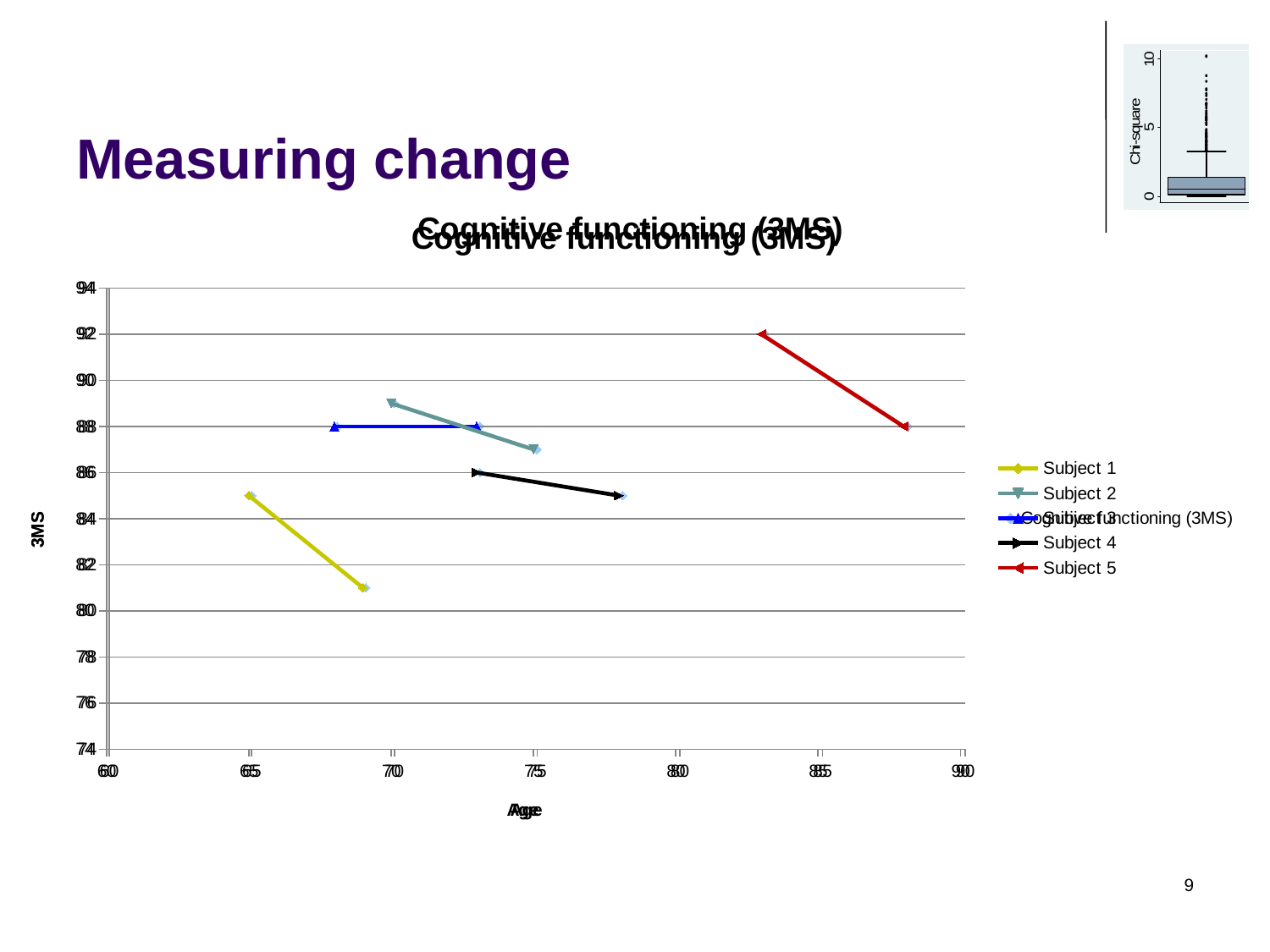
Does Subject 5's 3MS score rise or fall as age increases? fall Which subject reaches the highest 3MS value in the main chart? Subject 5 What is the highest 3MS value reached by Subject 5? 92 Does Subject 1's 3MS score rise or fall as age increases? fall What is the label of the x axis of the main chart? Age At what 3MS value does Subject 3's line stay flat? 88 Which subject has the lowest 3MS value in the main chart? Subject 1 Is the starting 3MS value for Subject 5 greater or less than 90? greater Is the final 3MS value for Subject 1 greater or less than 84? less What kind of chart is shown on the slide under the heading 'Measuring change'? line chart How many subjects are plotted as lines in the main chart? 5 What is the title of the main chart? Cognitive functioning (3MS)